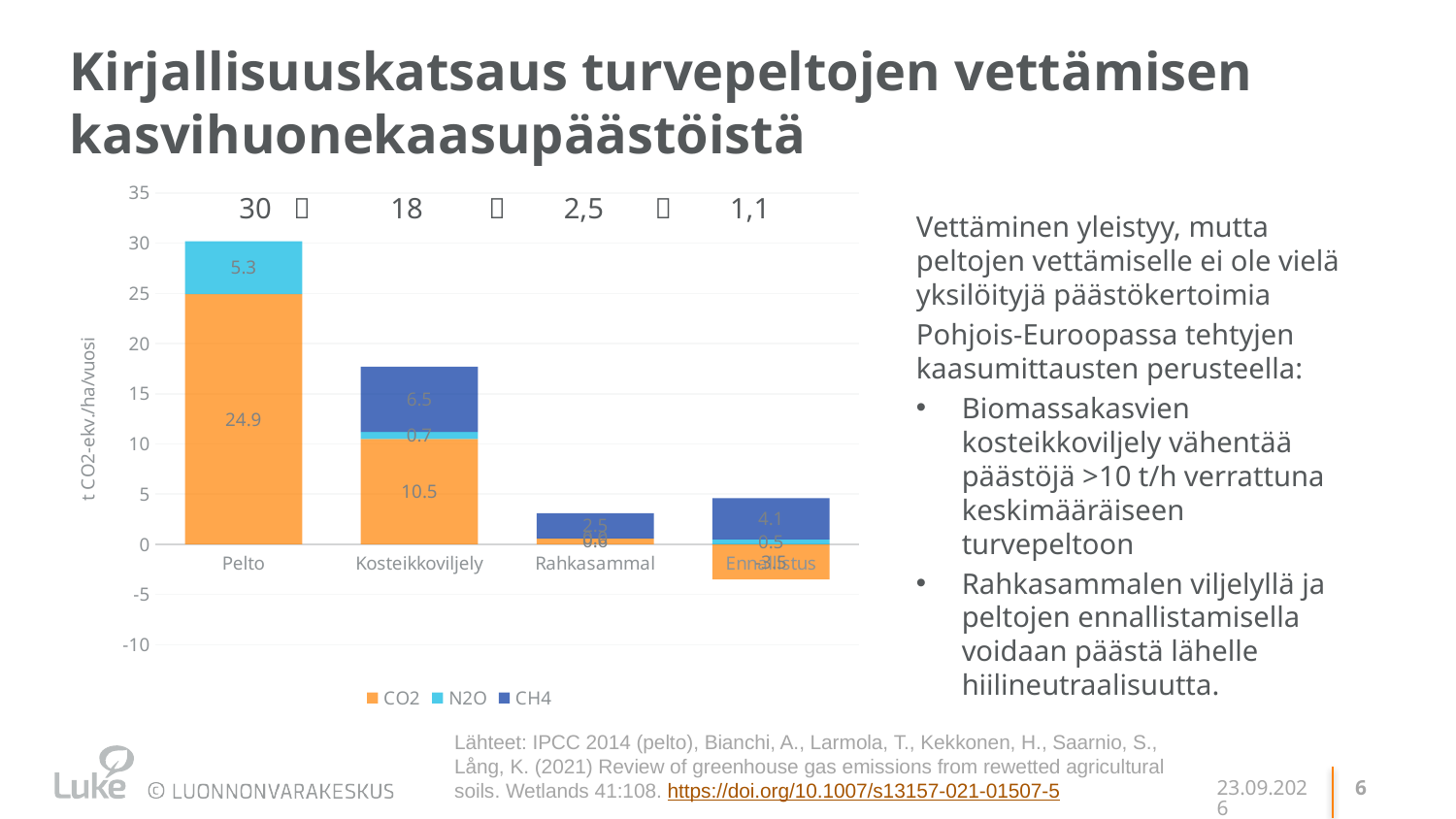
What is the N2O value for Pelto? 5.3 What is the N2O value for Kosteikkoviljely? 0.7 What is the label of the vertical axis of the chart? t CO2-ekv./ha/vuosi What kind of chart is shown on the slide? bar chart Which category has the highest total stacked bar? Pelto What is the CH4 value for Kosteikkoviljely? 6.5 How many categories are shown on the x axis of the chart? 4 How many series does the chart legend list? 3 Which has the larger CH4 value, Kosteikkoviljely or Ennallistus? Kosteikkoviljely What is the CO2 value for Kosteikkoviljely? 10.5 What is the difference between the CO2 value for Pelto and the CO2 value for Kosteikkoviljely? 14.4 What is the CO2 value for Pelto? 24.9